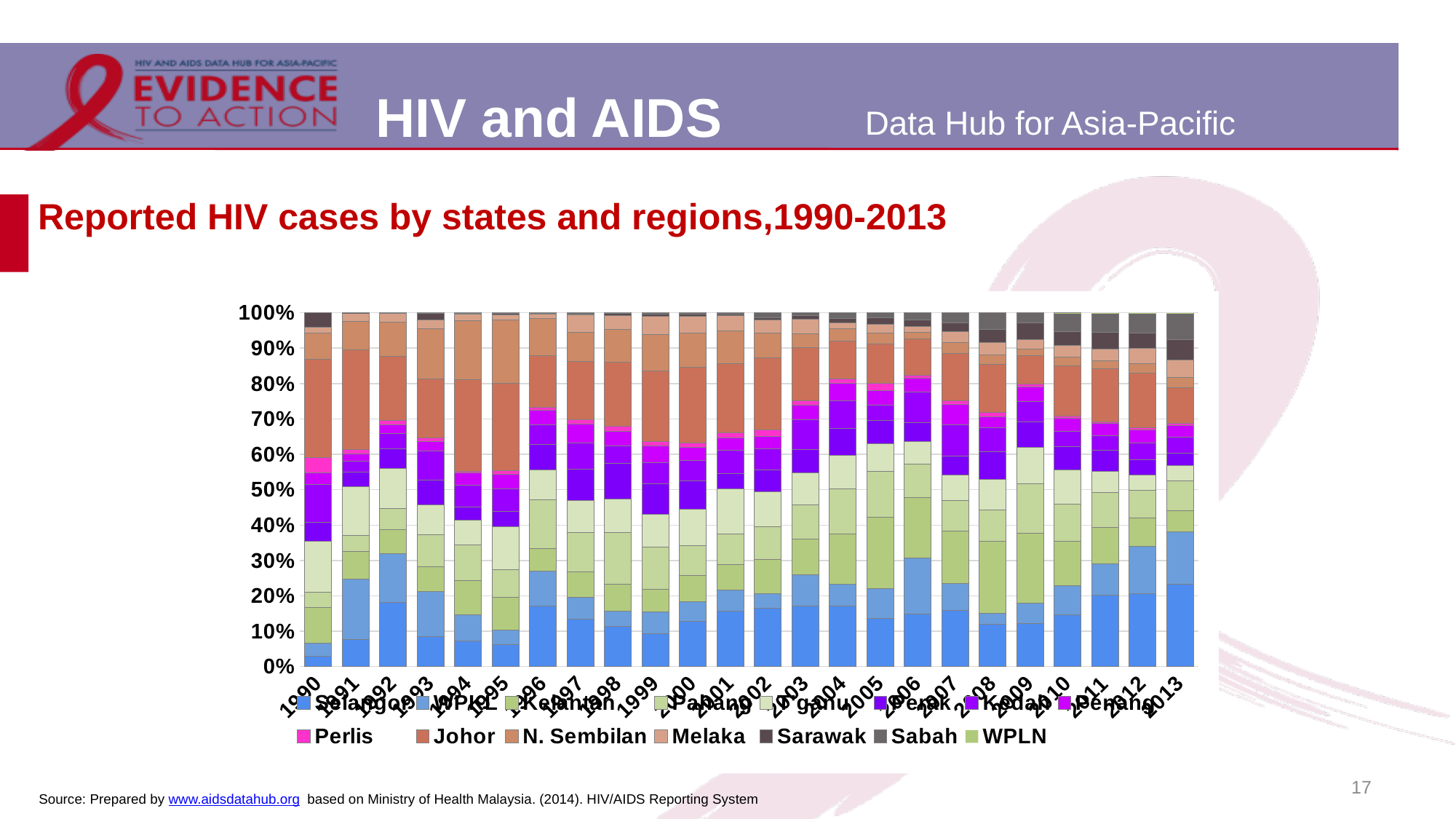
What is the last year shown on the x axis of the chart? 2013 How many years (categories) are shown along the x axis of the chart? 24 Is the share for Selangor in 1990 greater or less than 10%? less How many series does the chart's legend list? 15 Which series is listed first in the chart's legend? Selangor What kind of chart is shown on the slide? Stacked bar chart What is the title of the chart on the slide? Reported HIV cases by states and regions,1990-2013 Does the share for Johor generally rise or fall from 1990 to 2013? fall What is the first year shown on the x axis of the chart? 1990 Is the share for Selangor in 2013 greater or less than 30%? less Does the share for Selangor generally rise or fall from 1990 to 2013? rise What does each stacked bar in the chart total? 100%